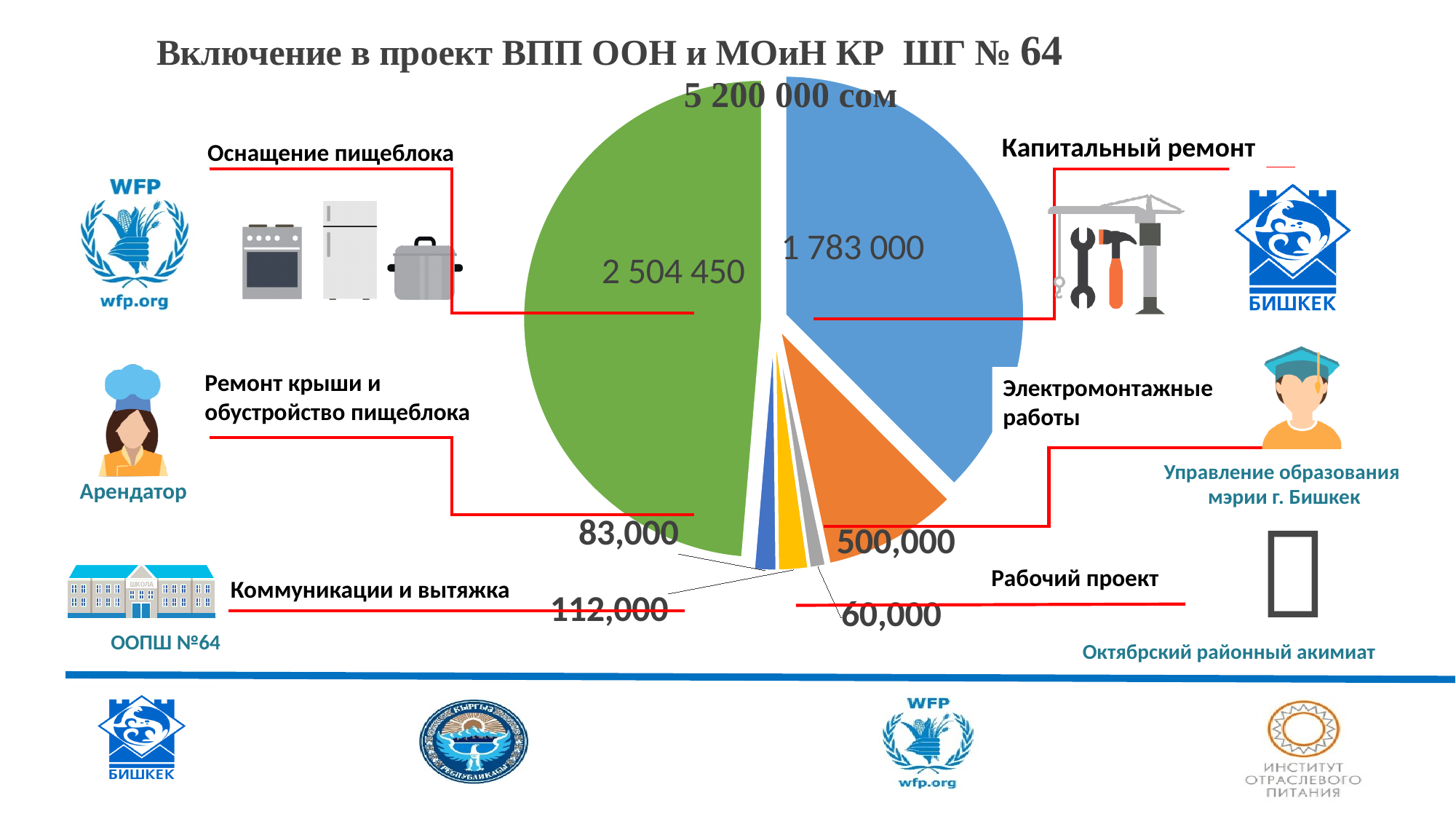
What is the value shown for Электромонтажные работы? 500,000 Which category has the smallest slice of the pie chart? Рабочий проект What is the difference between the values for Оснащение пищеблока and Капитальный ремонт? 721 450 What kind of chart is shown on the slide? pie chart What is the value shown for Оснащение пищеблока? 2 504 450 How many slices does the pie chart have? 6 What total amount is printed above the pie chart? 5 200 000 сом What is the difference between the values for Электромонтажные работы and Коммуникации и вытяжка? 388,000 Which category has the largest slice of the pie chart? Оснащение пищеблока What is the value shown for Капитальный ремонт? 1 783 000 What is the value shown for Рабочий проект? 60,000 Which is larger: the value for Электромонтажные работы or for Коммуникации и вытяжка? Электромонтажные работы